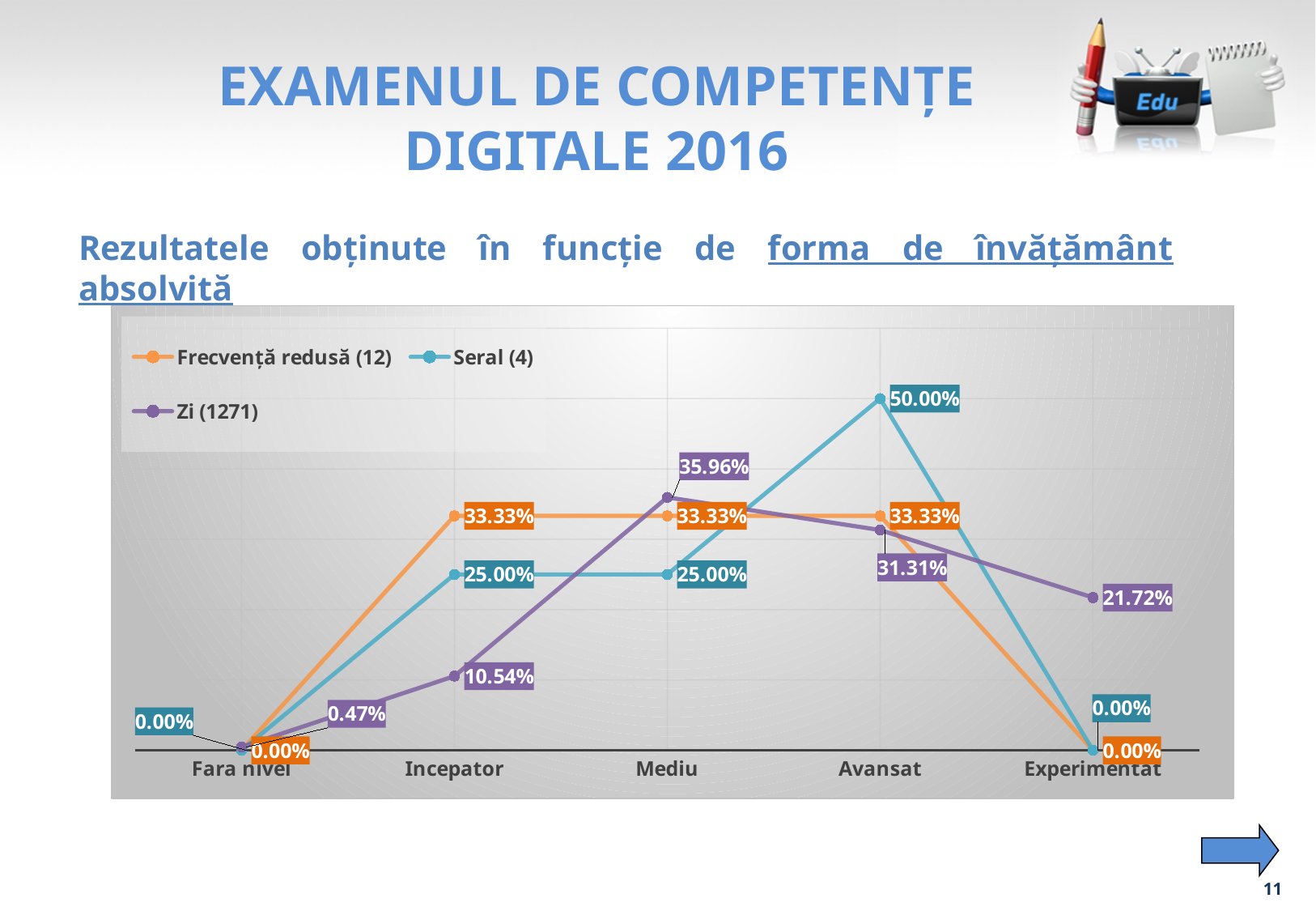
Which is larger at Avansat: the value for Seral (4) or the value for Frecvență redusă (12)? Seral (4) What is the value for Zi (1271) at Experimentat? 21.72% At which category does the Seral (4) series reach its highest value? Avansat What is the value for Zi (1271) at Mediu? 35.96% What is the value for Seral (4) at Avansat? 50.00% At which category does the Zi (1271) series have its lowest value? Fara nivel How many categories are shown on the x axis? 5 What is the value for Frecvență redusă (12) at Incepator? 33.33% What type of chart is shown on the slide? line chart How many series does the legend list? 3 What is the difference between the Zi (1271) values at Mediu and Incepator? 25.42% Which series is drawn in purple? Zi (1271)